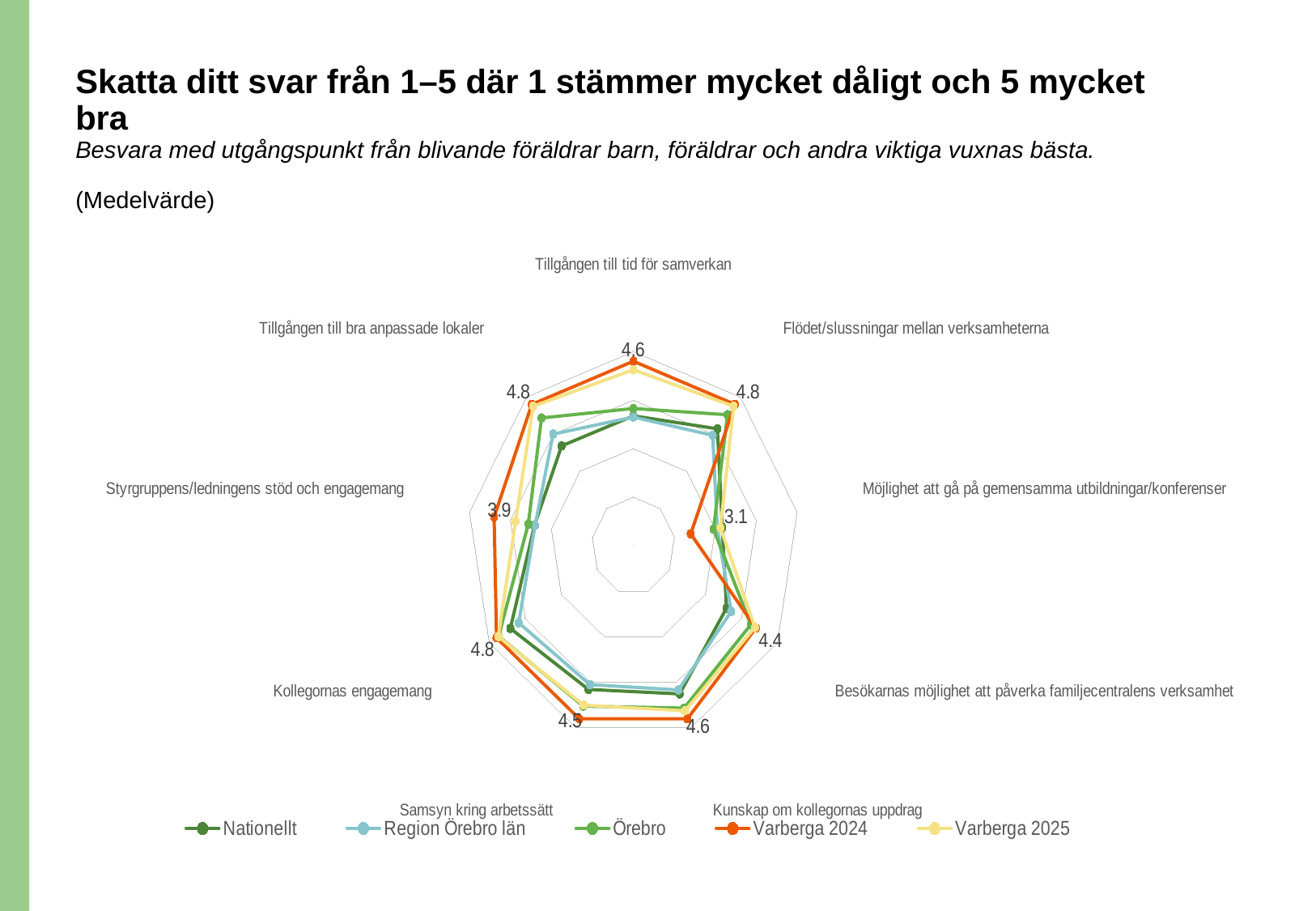
Which series is drawn in orange? Varberga 2024 For 'Kunskap om kollegornas uppdrag', which is higher: Varberga 2024 or Nationellt? Varberga 2024 For which category does Varberga 2025 have its lowest value? Möjlighet att gå på gemensamma utbildningar/konferenser What kind of chart is shown on the slide? Radar chart How many categories (axes) does the radar chart have? 9 For which category does Varberga 2024 have its lowest value? Möjlighet att gå på gemensamma utbildningar/konferenser For 'Tillgången till bra anpassade lokaler', which is higher: Nationellt or Varberga 2024? Varberga 2024 Which series is drawn in yellow? Varberga 2025 For 'Tillgången till tid för samverkan', which is higher: Varberga 2024 or Nationellt? Varberga 2024 How many series does the legend list? 5